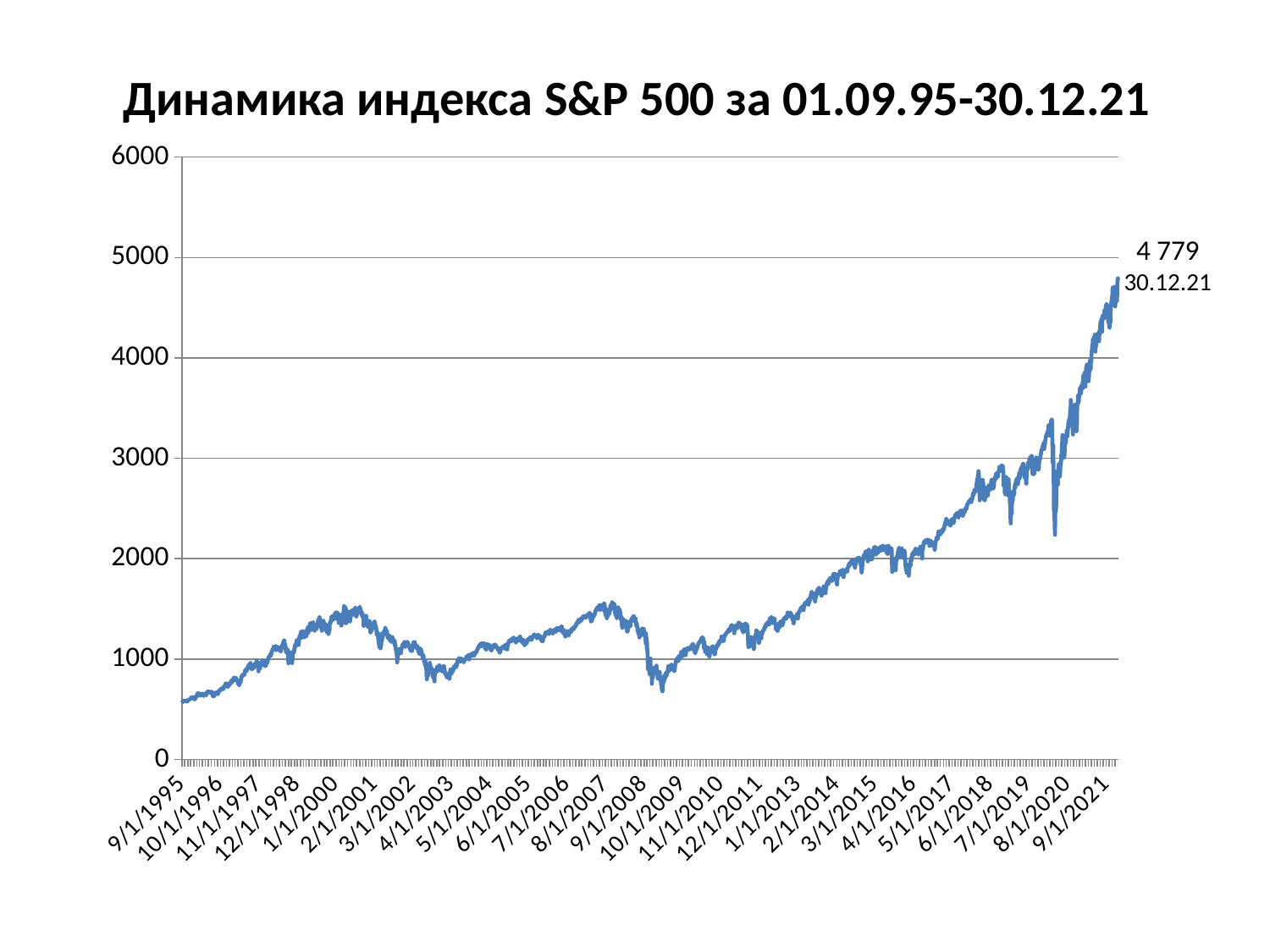
Is the value of the index at 7/1/2006 greater or less than 1000? greater Overall, does the S&P 500 index rise or fall from 9/1/1995 to 9/1/2021? rise Is the value of the index at 9/1/2021 greater or less than 4000? greater What is the title of the chart? Динамика индекса S&P 500 за 01.09.95-30.12.21 Is the value of the index at 8/1/2020 greater or less than 2000? greater What value is labelled at the end of the line, on 30.12.21? 4 779 What is the highest tick value shown on the vertical axis? 6000 What date is printed next to the final data label on the chart? 30.12.21 Which is larger, the index value at 9/1/2021 or at 9/1/1995? 9/1/2021 What kind of chart is shown on the slide? line chart